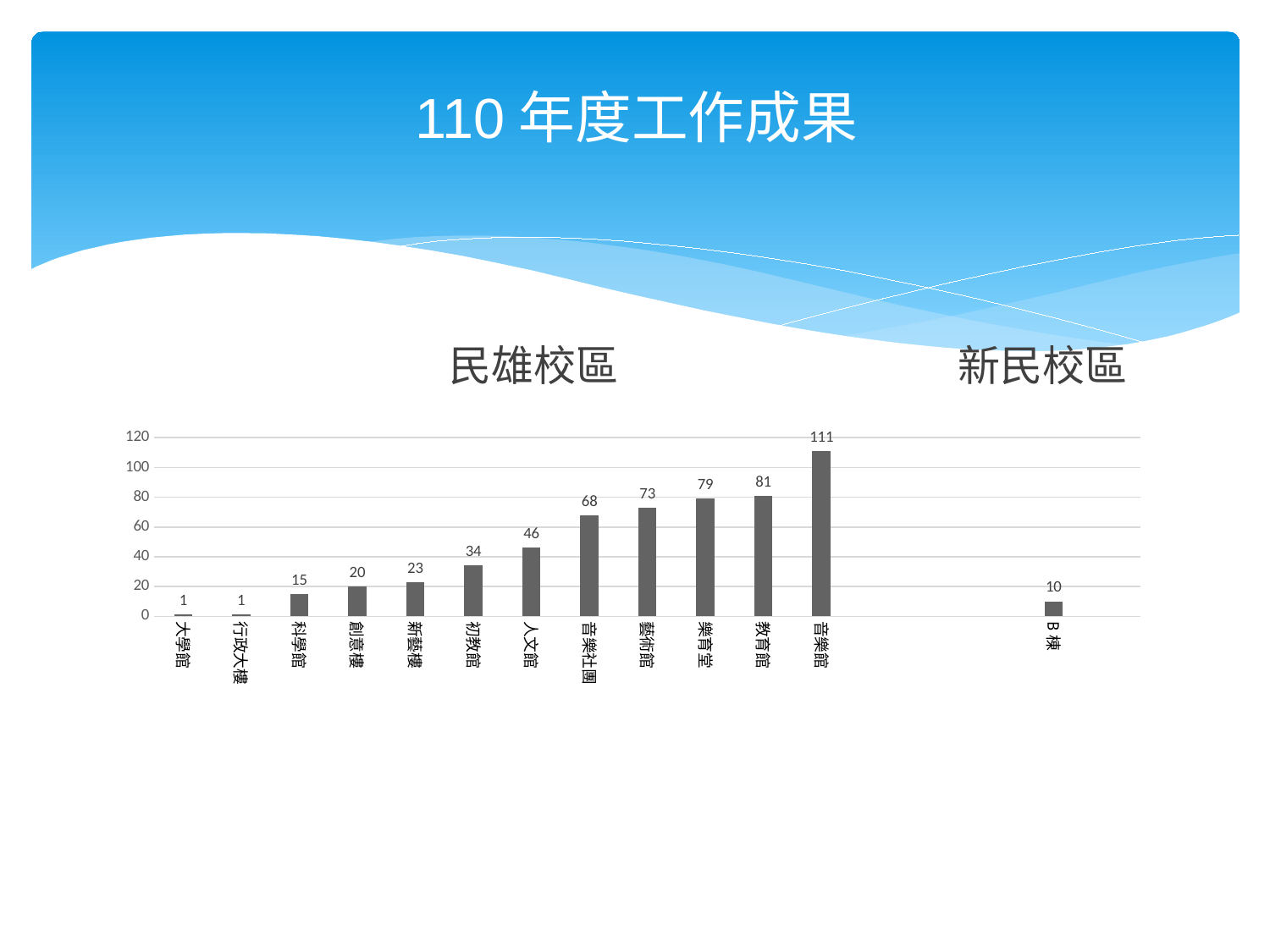
Do the values for the 民雄校區 categories rise or fall from left to right along the x axis? rise Which is larger, the value for 人文館 or the value for 藝術館? 藝術館 What is the value for 音樂館? 111 Which category has the highest value? 音樂館 Which campus label appears above the B棟 bar? 新民校區 How many categories are shown on the x axis? 13 What is the value for 初教館? 34 What is the title of the slide? 110 年度工作成果 What is the difference between the values for 教育館 and 音樂社團? 13 What is the value for B棟? 10 What kind of chart is shown on the slide? bar chart Is the value for 樂育堂 greater or less than 60? greater